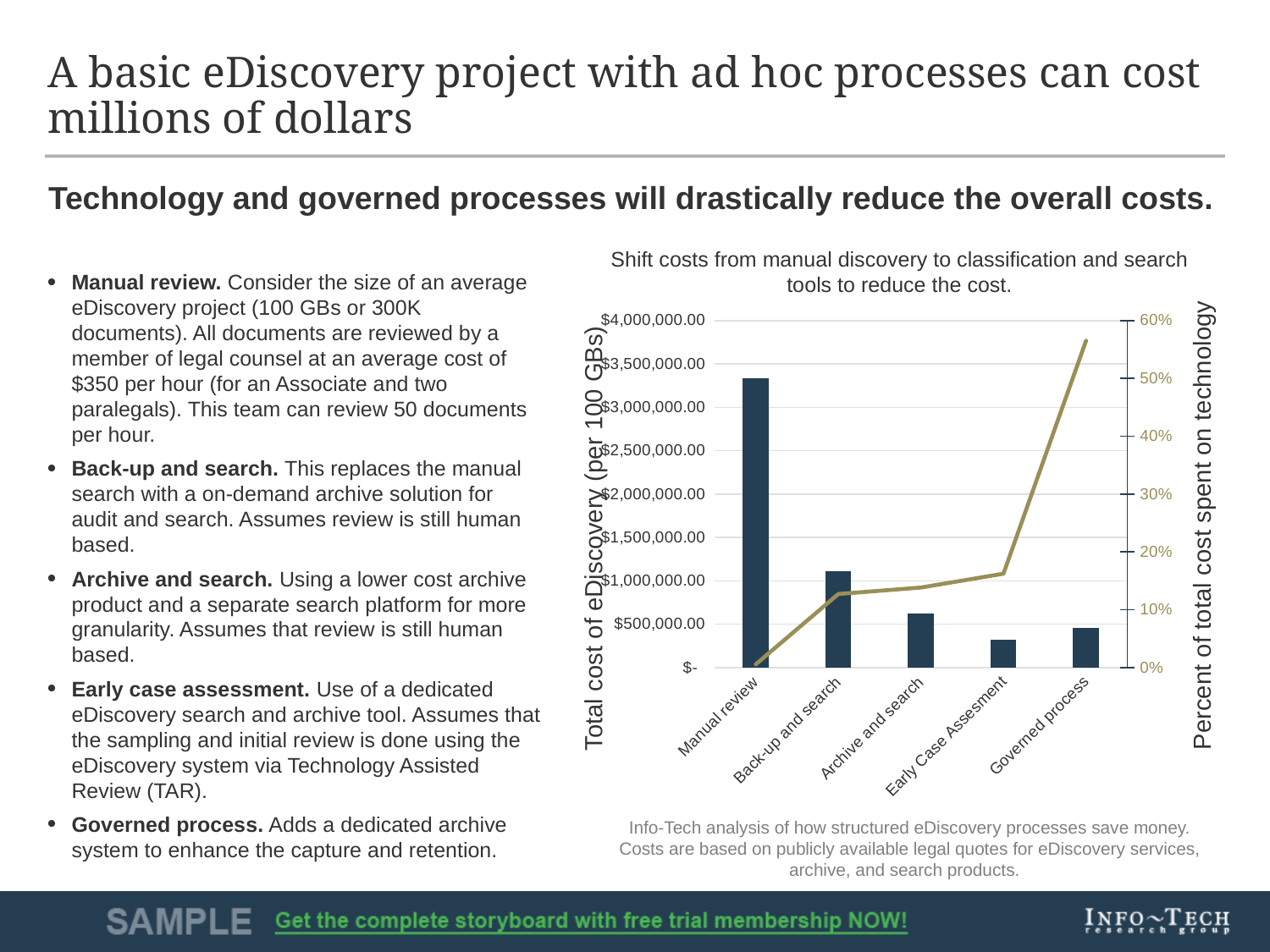
Does the percent of total cost spent on technology line rise or fall from Manual review to Governed process? Rise What is the title of the right-hand vertical axis of the chart? Percent of total cost spent on technology Is the total cost bar for Early Case Assesment greater or less than $500,000.00? less Is the total cost bar for Archive and search greater or less than $500,000.00? greater Which category has the lowest total cost of eDiscovery bar? Early Case Assesment Which has the larger total cost bar, Governed process or Early Case Assesment? Governed process What kind of chart is shown on the slide? Bar chart with a line Which category has the highest total cost of eDiscovery bar? Manual review How many categories are shown on the x axis of the chart? 5 Is the total cost bar for Manual review greater or less than $3,000,000.00? greater